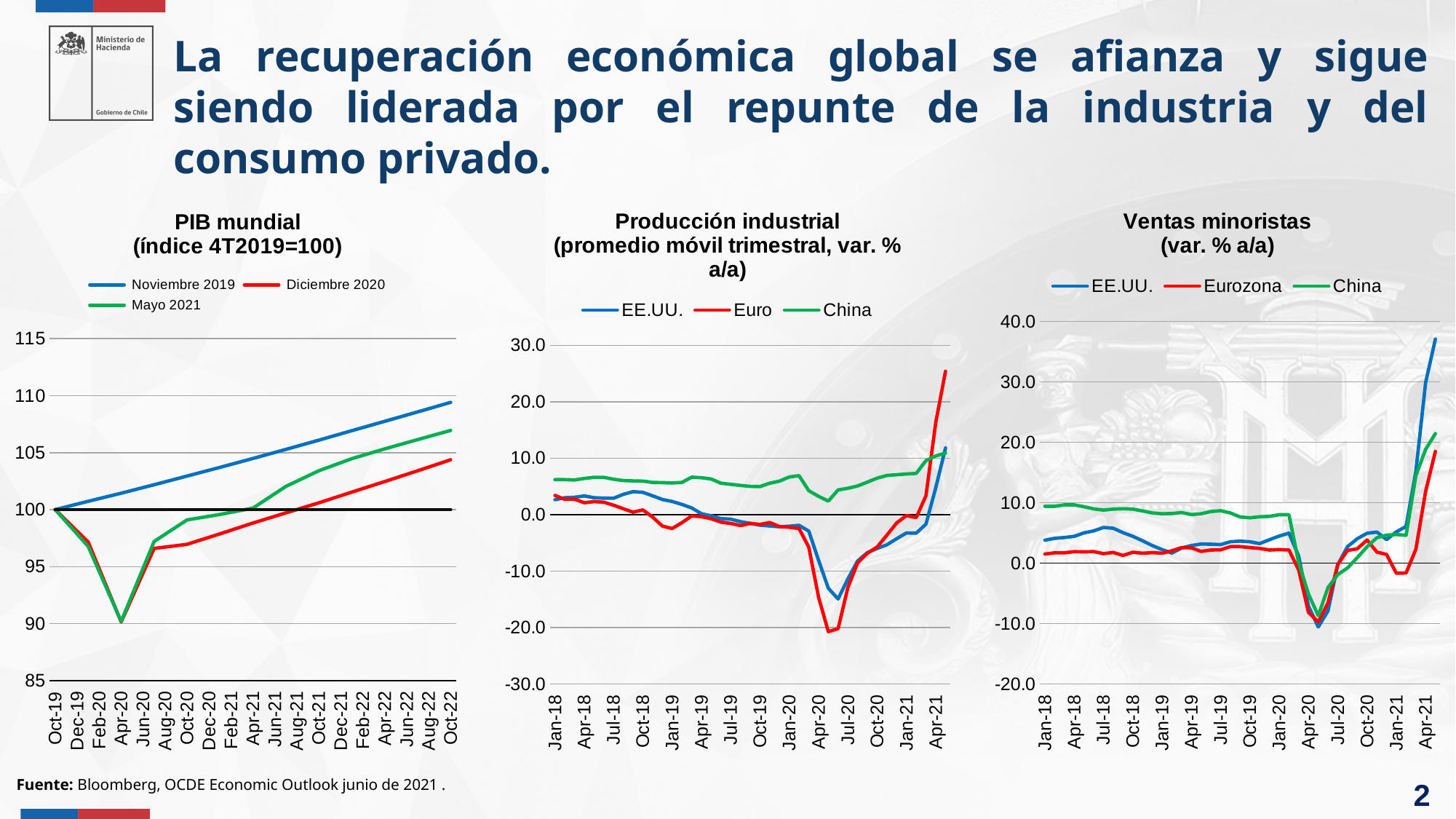
In the 'PIB mundial' chart, which series are listed in the legend? Noviembre 2019, Diciembre 2020, Mayo 2021 In the 'PIB mundial' chart, does the Noviembre 2019 series rise or fall from Oct-19 to Oct-22? rise How many charts are shown on the slide? 3 In the 'Producción industrial' chart, which series reaches the lowest value around Apr-20? Euro What kind of chart is the 'PIB mundial' chart on the left? line chart In the 'PIB mundial' chart, is the value of the Noviembre 2019 series at Oct-22 greater or less than 105? greater How many series does the legend of the 'Producción industrial' chart list? 3 How many series does the legend of the 'PIB mundial' chart list? 3 In the 'PIB mundial' chart, which series is higher at Oct-22, Noviembre 2019 or Diciembre 2020? Noviembre 2019 In the 'PIB mundial' chart, is the value of the Diciembre 2020 series at Apr-20 greater or less than 95? less